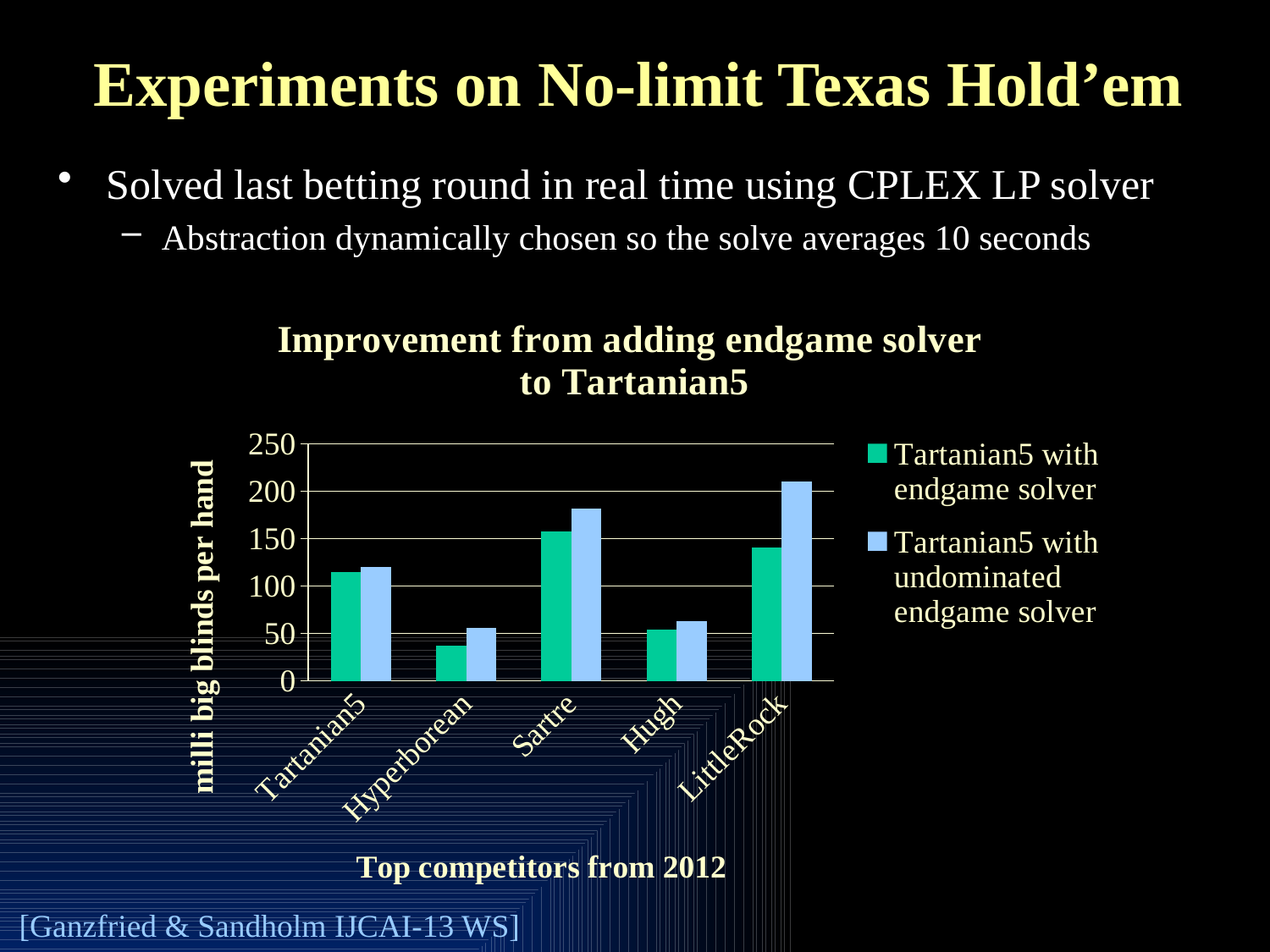
Is the value for Hyperborean in the 'Tartanian5 with endgame solver' series greater or less than 50? less Is the value for Sartre in the 'Tartanian5 with endgame solver' series greater or less than 150? greater What is the label of the chart's y axis? milli big blinds per hand Which competitor has the lowest value for the 'Tartanian5 with undominated endgame solver' series? Hyperborean Which is larger: the 'Tartanian5 with endgame solver' value for Sartre or for Hugh? Sartre How many competitors are shown along the x axis of the chart? 5 Which competitor has the highest value for the 'Tartanian5 with undominated endgame solver' series? LittleRock How many series does the chart's legend list? 2 For LittleRock, which series has the larger value: 'Tartanian5 with endgame solver' or 'Tartanian5 with undominated endgame solver'? Tartanian5 with undominated endgame solver Which competitor has the lowest value for the 'Tartanian5 with endgame solver' series? Hyperborean Is the value for LittleRock in the 'Tartanian5 with undominated endgame solver' series greater or less than 200? greater What kind of chart is shown on the slide? bar chart